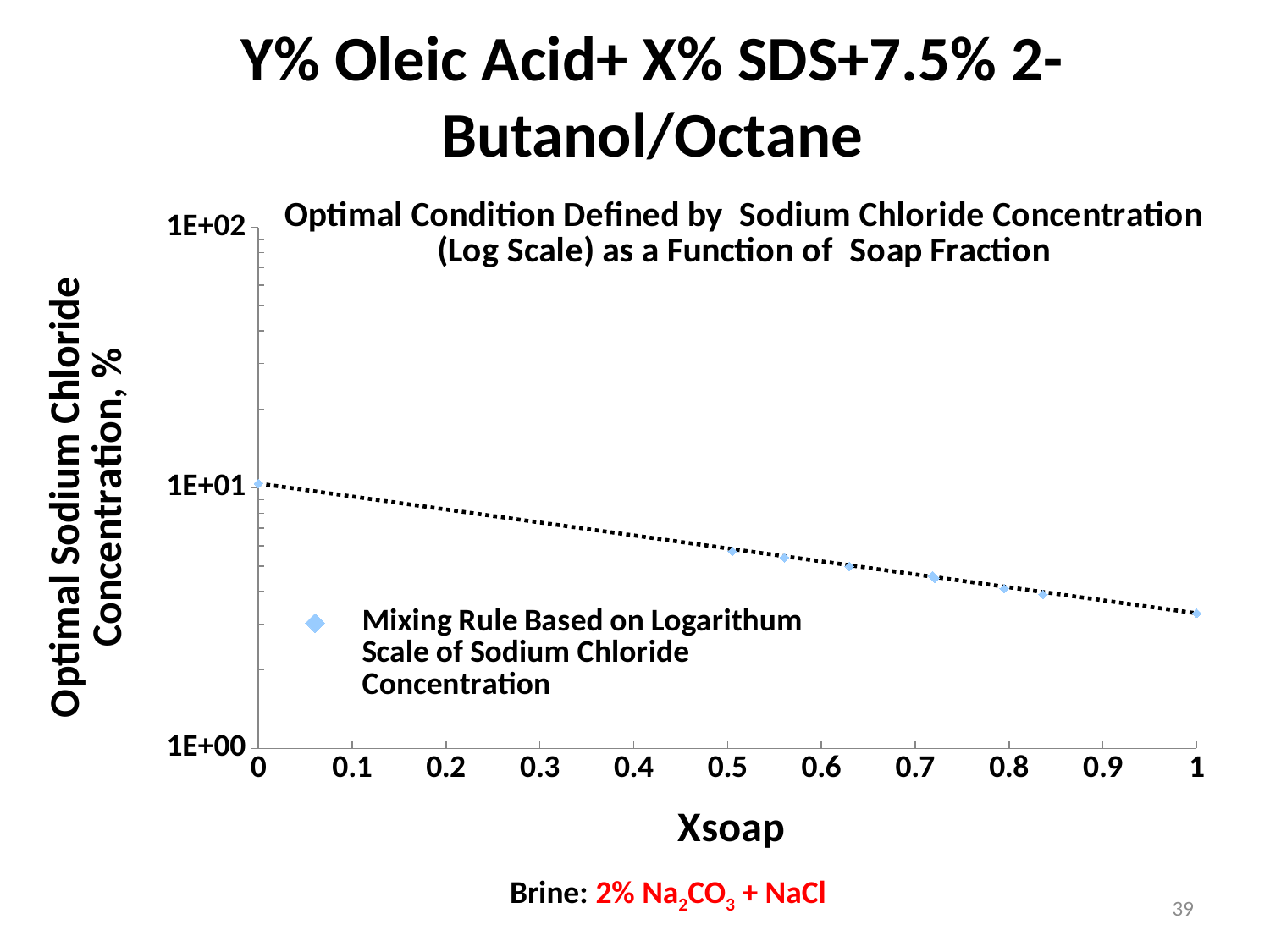
Is the value at Xsoap = 0.5 greater or less than 1E+01? less Which has the larger optimal sodium chloride concentration, Xsoap = 0 or Xsoap = 1? Xsoap = 0 Do the plotted values rise or fall as Xsoap increases from 0 to 1? Fall Is the value at Xsoap = 0 greater or less than 1E+00? greater What is the label of the x axis? Xsoap How many series does the legend list? 1 At which Xsoap value is the optimal sodium chloride concentration lowest? 1 Is the value at Xsoap = 1 greater or less than 1E+01? less At which Xsoap value is the optimal sodium chloride concentration highest? 0 What kind of chart is shown on the slide? Scatter chart What is the label of the y axis? Optimal Sodium Chloride Concentration, %